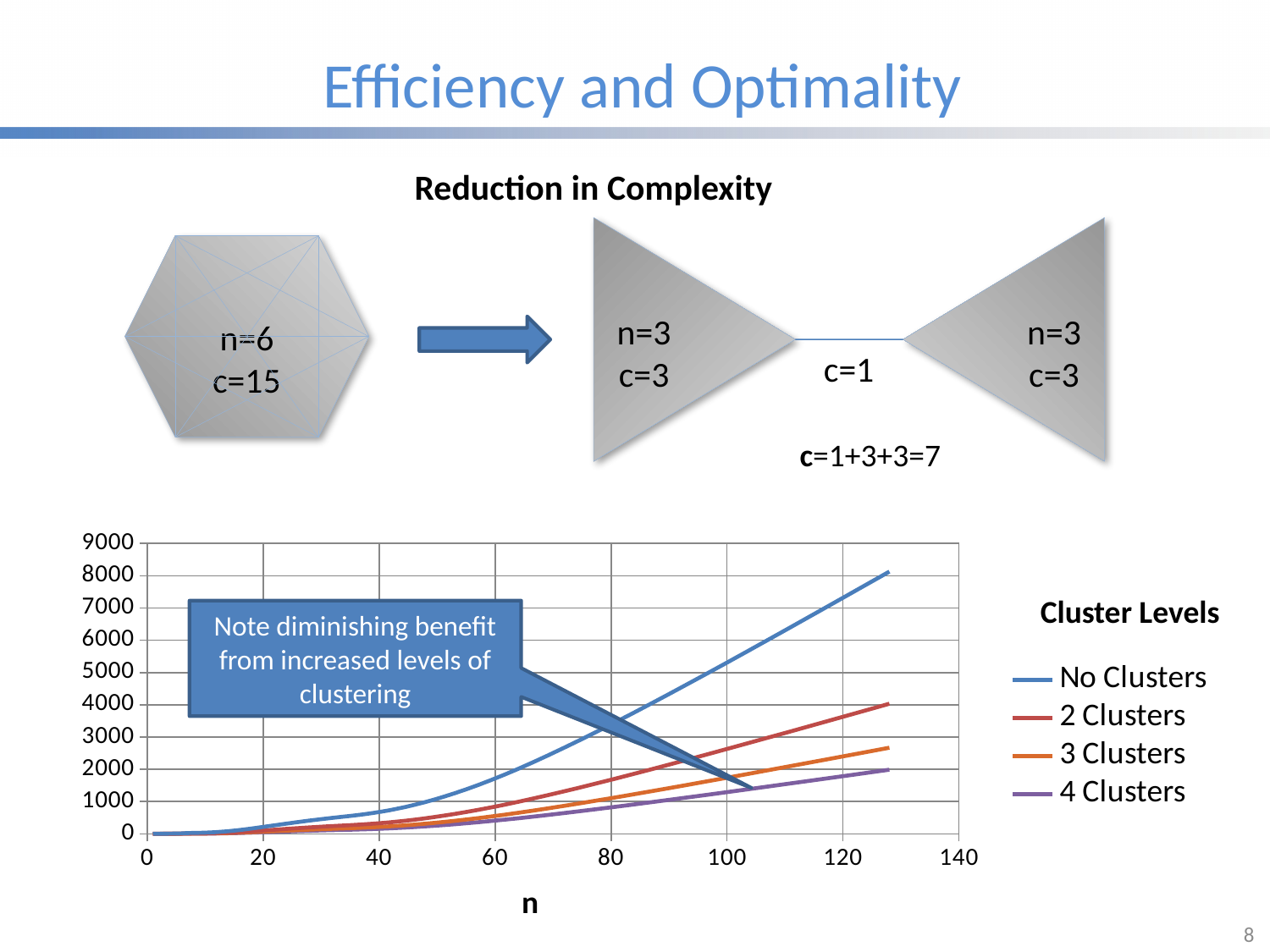
On the line chart, is the value of the No Clusters series at its right-hand end greater or less than 7000? greater On the line chart, is the value of the 4 Clusters series at its right-hand end greater or less than 3000? less Which series on the line chart has the lowest value at n = 120? 4 Clusters Which series on the line chart has the highest value at n = 120? No Clusters Do the values of the No Clusters series rise or fall as n increases along the x axis? rise On the line chart, which is larger at n = 100: the No Clusters series or the 3 Clusters series? No Clusters What kind of chart is shown at the bottom of the slide? line chart On the line chart, is the value of the 2 Clusters series at n = 120 greater or less than 3000? greater How many series does the legend of the line chart list? 4 What is the title of the legend on the line chart? Cluster Levels What is the highest value shown on the y axis of the line chart? 9000 What is the label of the x axis on the line chart? n